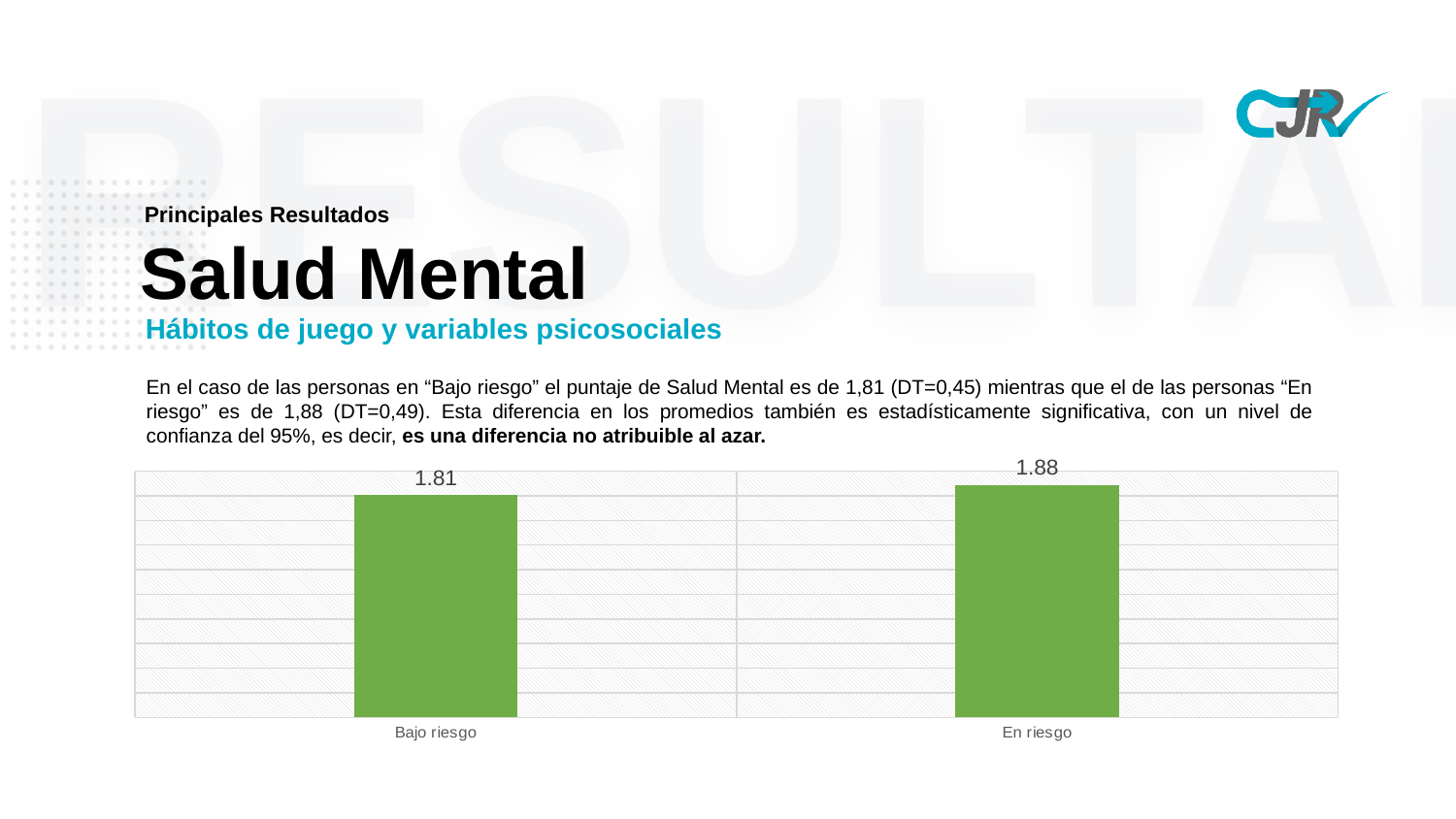
What kind of chart is shown on the slide? Bar chart What colour are the bars in the chart? Green What is the difference between the values for En riesgo and Bajo riesgo? 0.07 What are the two category labels on the x axis of the chart? Bajo riesgo and En riesgo Which category has the lowest value? Bajo riesgo Which category has the highest value? En riesgo Which is larger, the value for Bajo riesgo or the value for En riesgo? En riesgo What is the value for Bajo riesgo? 1.81 How many categories are shown in the chart? 2 What is the value for En riesgo? 1.88 Do the values rise or fall from Bajo riesgo to En riesgo? Rise